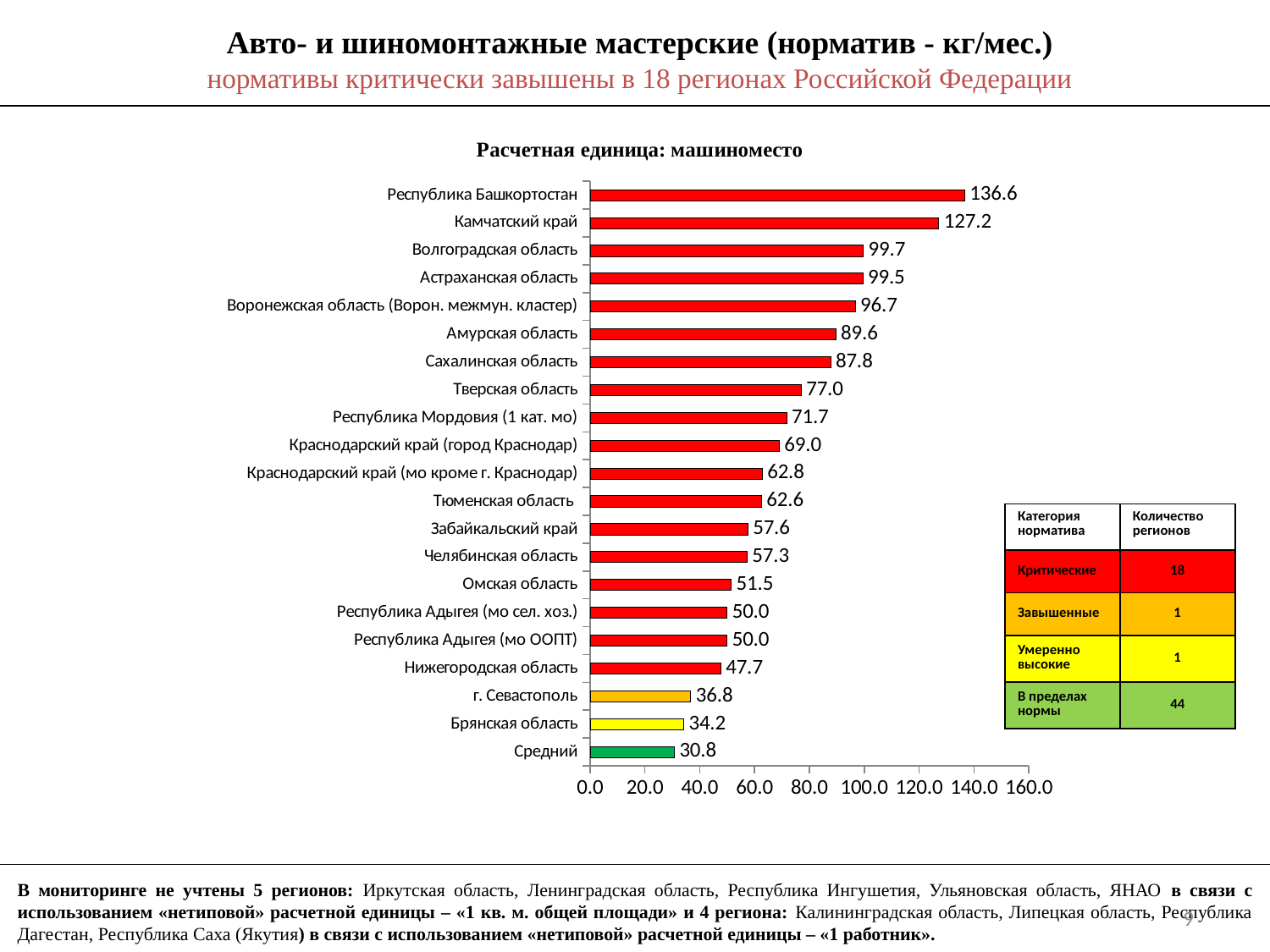
What is the difference between the values for Республика Башкортостан and Камчатский край? 9.4 Which category has the highest value? Республика Башкортостан How many categories are plotted in the chart? 21 What is the value for Тверская область? 77.0 What kind of chart is shown on the slide? bar chart What is the title of the chart? Расчетная единица: машиноместо What is the difference between the values for г. Севастополь and Брянская область? 2.6 What is the value for Камчатский край? 127.2 What is the value for Средний? 30.8 Is the value for Сахалинская область greater or less than 80.0? greater Which is larger, the value for Амурская область or the value for Омская область? Амурская область Which category has the lowest value? Средний